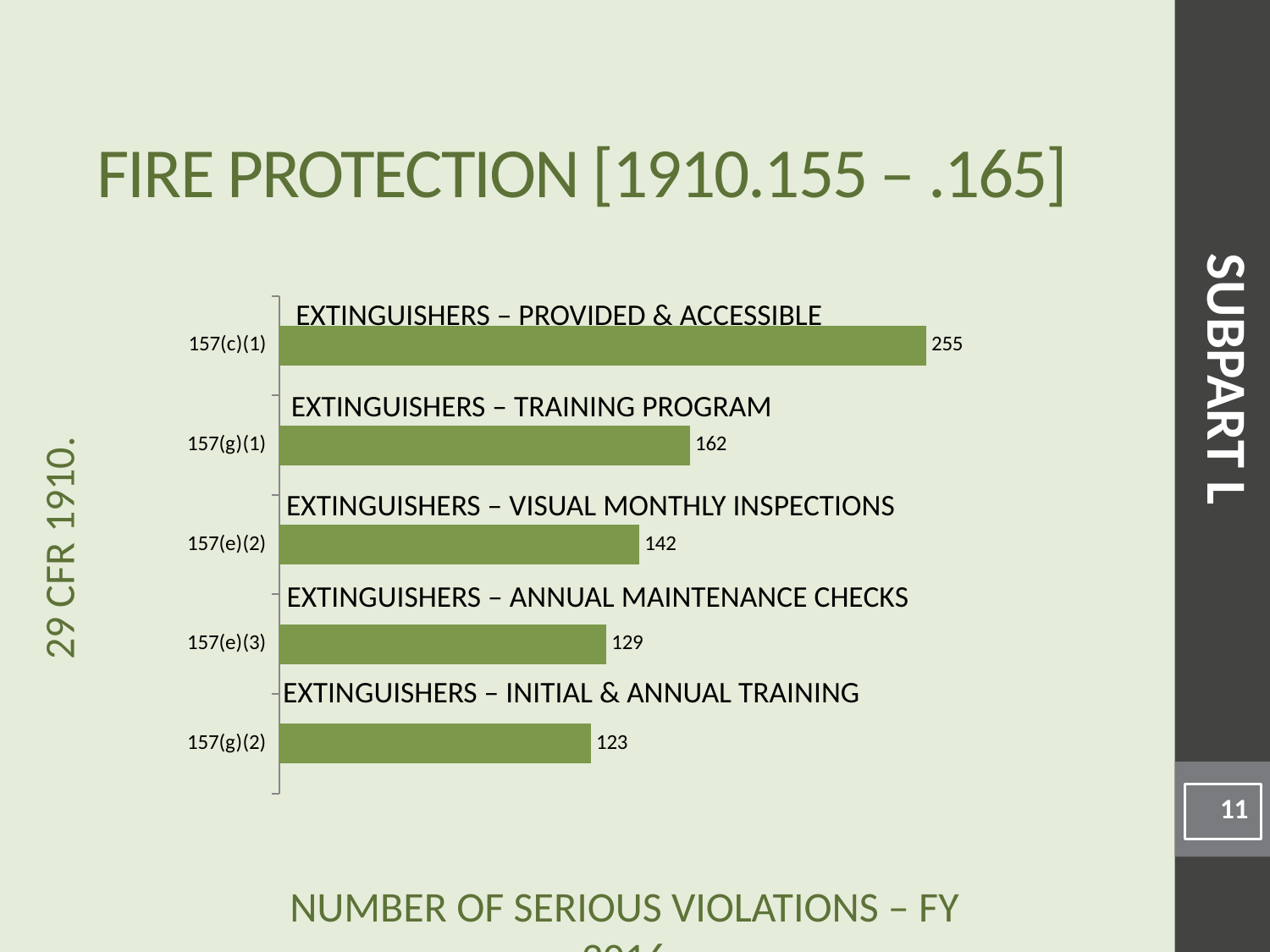
What is the difference between the values for 157(c)(1) and 157(g)(1)? 93 What is the value for 157(e)(2)? 142 Which category has the lowest value? 157(g)(2) What kind of chart is shown on the slide? bar chart What is the text label shown above the bar for 157(c)(1)? EXTINGUISHERS – PROVIDED & ACCESSIBLE How many categories are shown in the chart? 5 Which category has the highest value? 157(c)(1) What is the value for 157(c)(1)? 255 What is the value for 157(g)(1)? 162 What is the value for 157(g)(2)? 123 Which is larger, the value for 157(e)(2) or the value for 157(e)(3)? 157(e)(2) What is the value for 157(e)(3)? 129